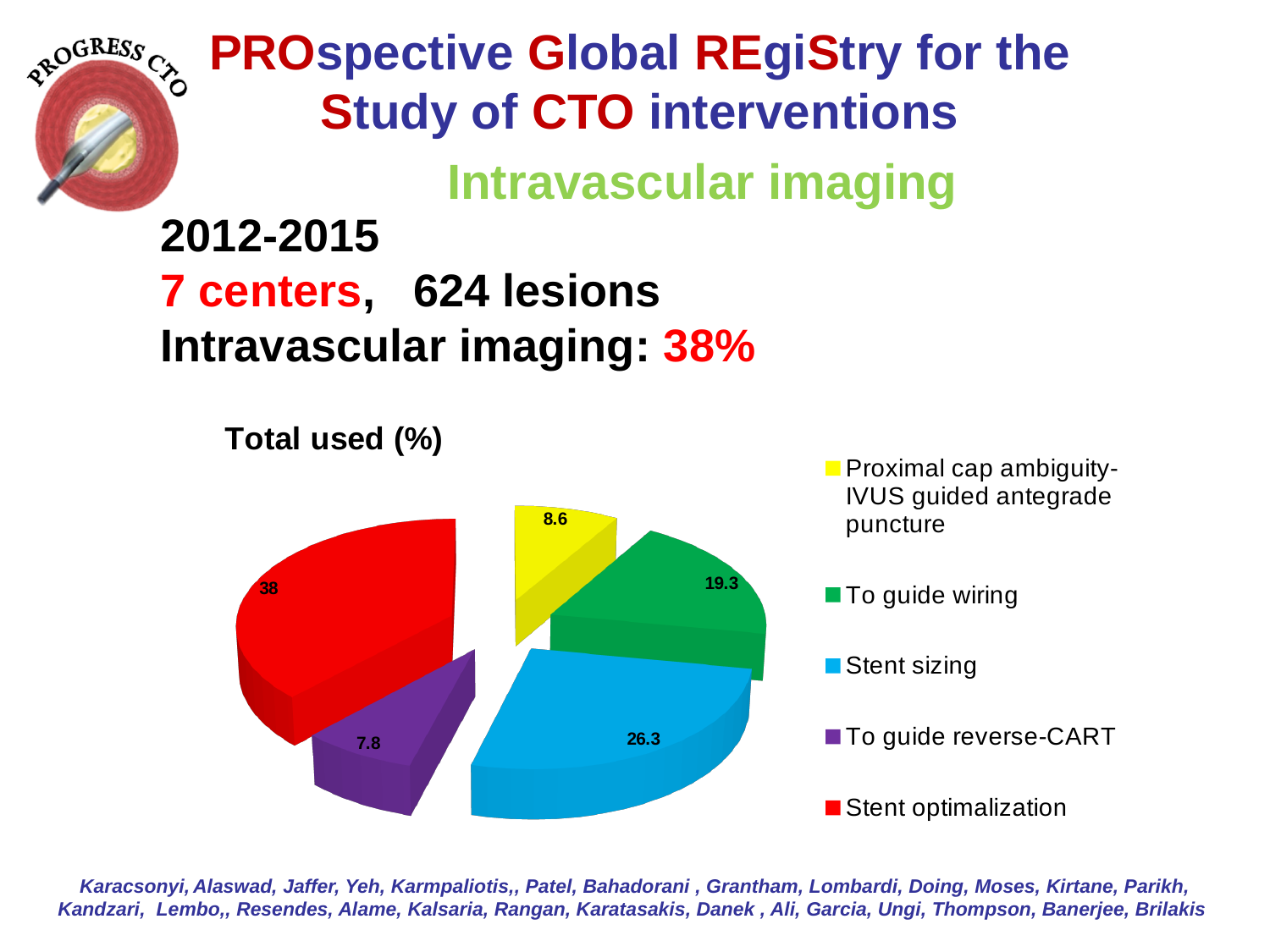
What is the value for To guide wiring? 19.3 How many slices does the pie chart have? 5 Which is larger, the value for Stent sizing or the value for To guide wiring? Stent sizing What is the title of the chart? Total used (%) What is the value for To guide reverse-CART? 7.8 What is the difference between the values for Stent optimalization and Stent sizing? 11.7 What is the value for Stent sizing? 26.3 Which colour represents Proximal cap ambiguity-IVUS guided antegrade puncture in the legend? Yellow Which category has the largest slice of the pie? Stent optimalization Which category has the smallest slice of the pie? To guide reverse-CART What is the value for Stent optimalization? 38 What type of chart is shown on the slide? Pie chart